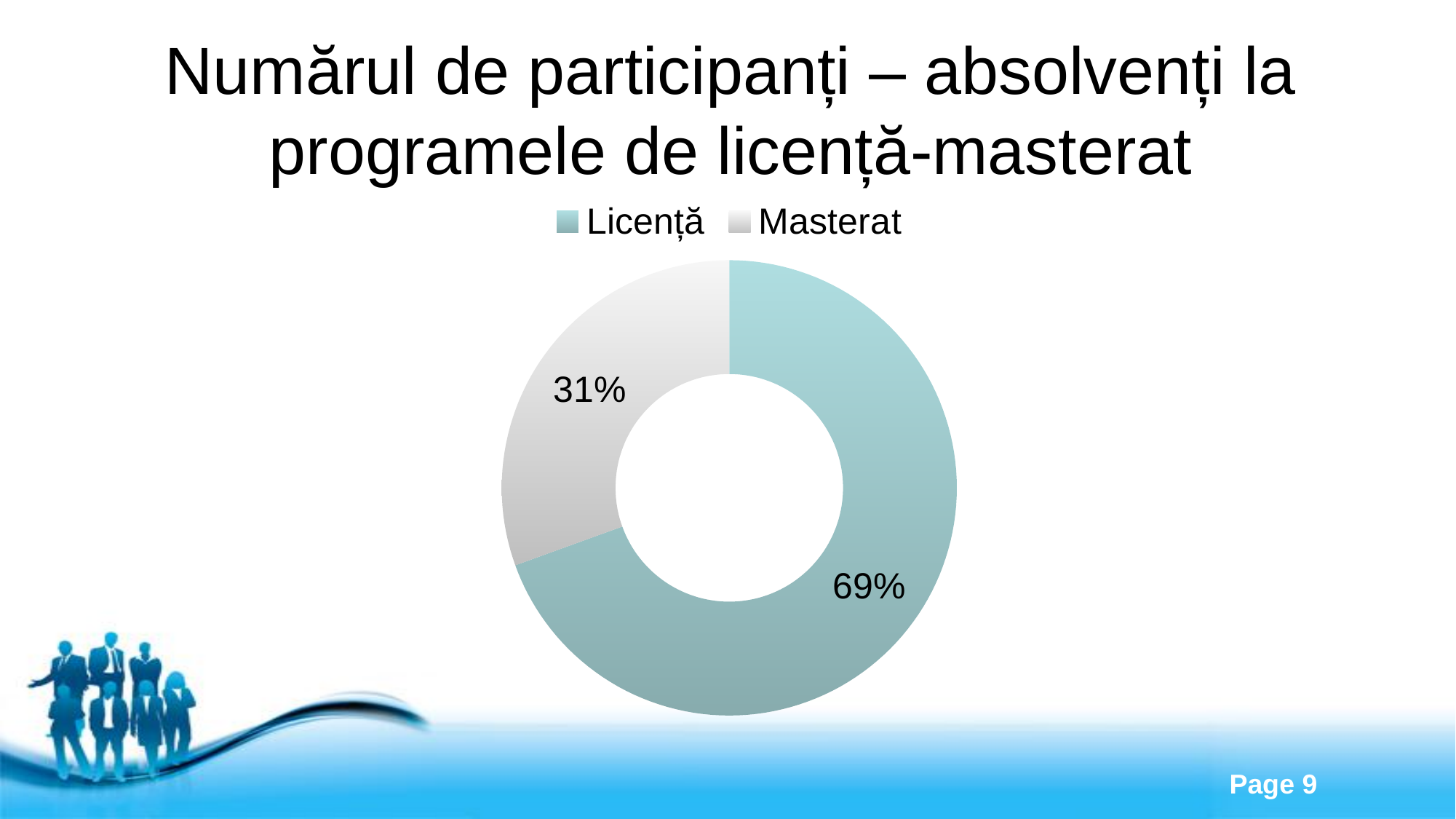
What percentage of participants are Licență graduates? 69% Which category has the smallest share of the chart? Masterat What is the difference in percentage points between the Licență and Masterat shares? 38 How many entries does the legend list? 2 What is the share of the chart taken by the Masterat slice? 31% Which is larger, the share for Licență or the share for Masterat? Licență What percentage of participants are Masterat graduates? 31% Which category is shown in the teal colour? Licență Which category has the largest share of the chart? Licență What kind of chart is shown on the slide? Doughnut chart What is the title of the chart on the slide? Numărul de participanți – absolvenți la programele de licență-masterat How many categories are shown in the chart? 2